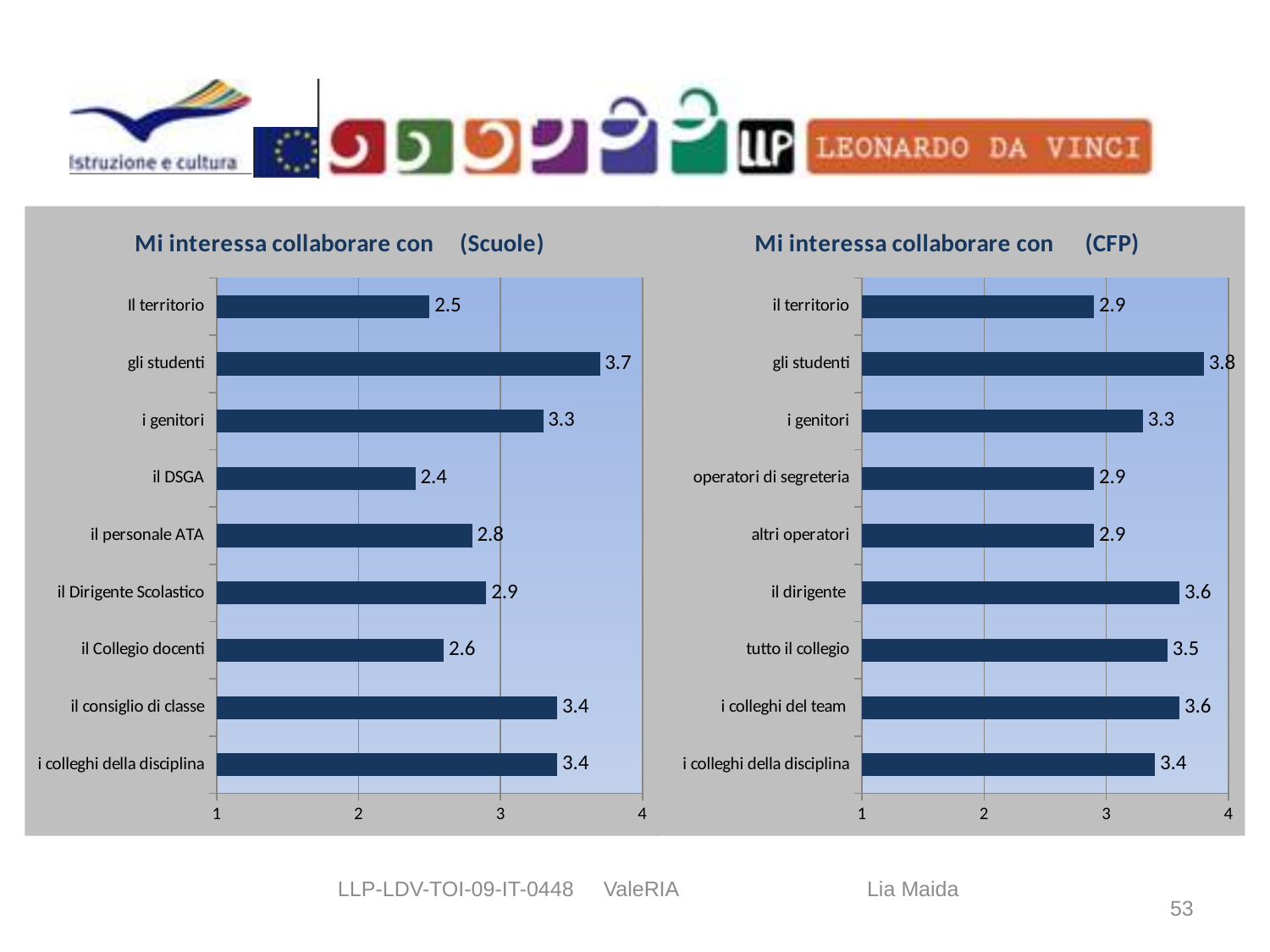
In the 'Mi interessa collaborare con (Scuole)' chart, which category has the highest value? gli studenti In the 'Mi interessa collaborare con (CFP)' chart, what is the difference between the values for il dirigente and il territorio? 0.7 In the 'Mi interessa collaborare con (Scuole)' chart, what is the difference between the values for gli studenti and Il territorio? 1.2 In the 'Mi interessa collaborare con (CFP)' chart, what is the value for operatori di segreteria? 2.9 In the 'Mi interessa collaborare con (Scuole)' chart, what is the value for il DSGA? 2.4 In the 'Mi interessa collaborare con (CFP)' chart, what is the value for tutto il collegio? 3.5 How many categories are shown in the 'Mi interessa collaborare con (CFP)' chart? 9 In the 'Mi interessa collaborare con (CFP)' chart, is the value for i colleghi del team greater or less than 3? greater In the 'Mi interessa collaborare con (Scuole)' chart, which is larger: the value for i genitori or the value for il personale ATA? i genitori In the 'Mi interessa collaborare con (CFP)' chart, which category has the highest value? gli studenti What kind of chart is the 'Mi interessa collaborare con (Scuole)' chart? bar chart In the 'Mi interessa collaborare con (Scuole)' chart, which category has the lowest value? il DSGA